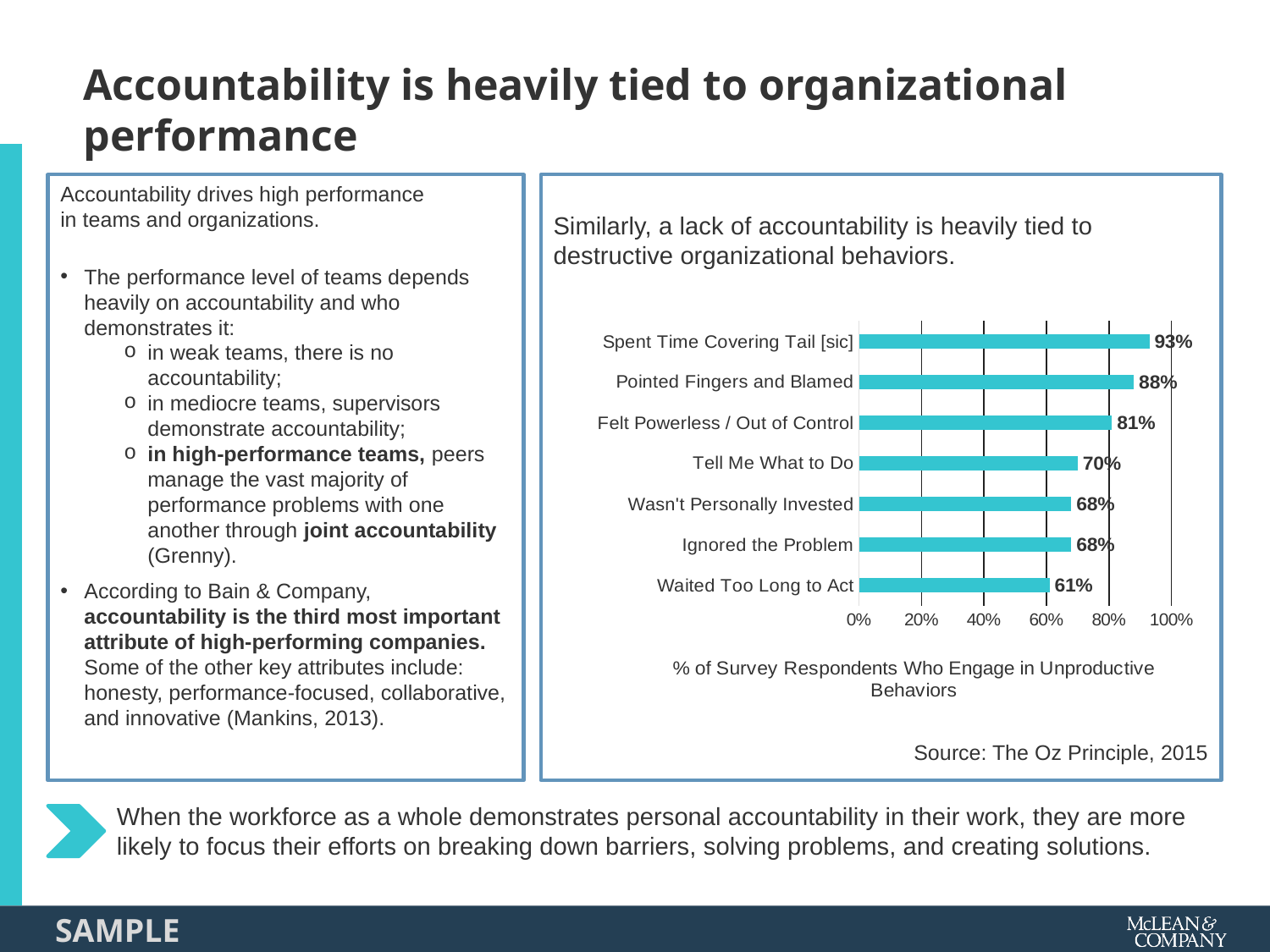
What percentage of survey respondents reported that they Spent Time Covering Tail? 93% What is the difference in percentage points between Pointed Fingers and Blamed and Tell Me What to Do? 18 How many unproductive behaviors are listed in the chart? 7 Which unproductive behavior has the lowest percentage of respondents? Waited Too Long to Act What percentage of respondents said they Waited Too Long to Act? 61% Is the value for Tell Me What to Do greater or less than 60%? greater What is the source cited for the chart data? The Oz Principle, 2015 What is the label shown beneath the chart's x axis? % of Survey Respondents Who Engage in Unproductive Behaviors What is the value shown for Felt Powerless / Out of Control? 81% Which has a higher value: Felt Powerless / Out of Control or Ignored the Problem? Felt Powerless / Out of Control What type of chart is used to show the percentage of survey respondents who engage in unproductive behaviors? Bar chart Which unproductive behavior has the highest percentage of respondents? Spent Time Covering Tail [sic]